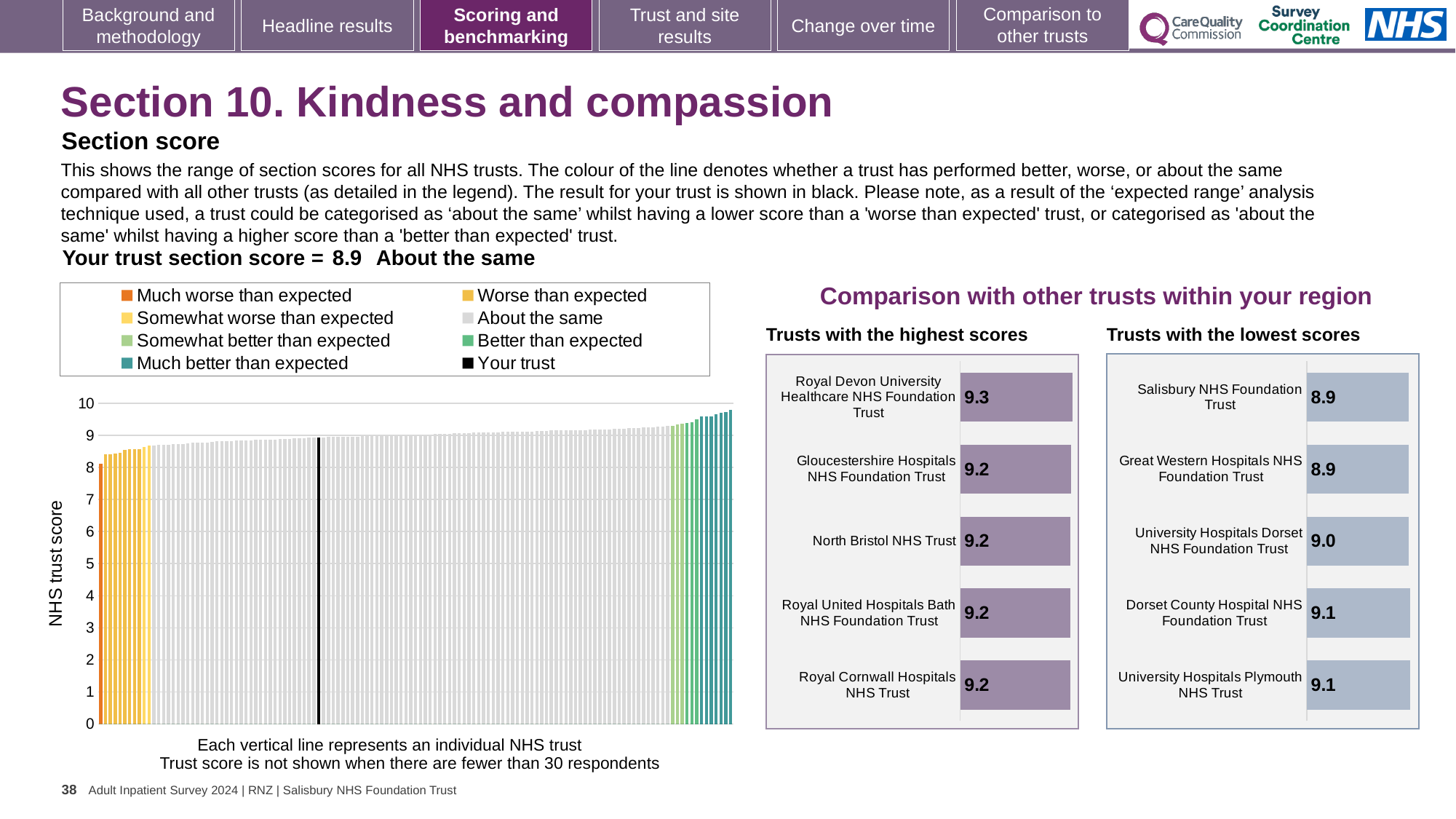
In the 'Trusts with the lowest scores' chart, what is the difference between the scores of University Hospitals Plymouth NHS Trust and Salisbury NHS Foundation Trust? 0.2 In the 'Trusts with the highest scores' chart, which trust has the highest score? Royal Devon University Healthcare NHS Foundation Trust In the 'Trusts with the highest scores' chart, how many trusts are shown? 5 In the large chart on the left, is the value of the black bar (your trust) greater or less than 5? greater In the 'Trusts with the lowest scores' chart, what is the score for University Hospitals Dorset NHS Foundation Trust? 9.0 In the large chart on the left, how many entries does the legend list? 8 In the 'Trusts with the highest scores' chart, what is the difference between the scores of Royal Devon University Healthcare NHS Foundation Trust and North Bristol NHS Trust? 0.1 In the 'Trusts with the lowest scores' chart, which has the larger score: Dorset County Hospital NHS Foundation Trust or University Hospitals Dorset NHS Foundation Trust? Dorset County Hospital NHS Foundation Trust In the 'Trusts with the highest scores' chart, what is the score for Royal Devon University Healthcare NHS Foundation Trust? 9.3 In the large chart on the left, do the bars rise or fall from left to right? rise What is the label on the vertical axis of the large chart on the left? NHS trust score What kind of chart is the large chart on the left showing the range of section scores for all NHS trusts? bar chart